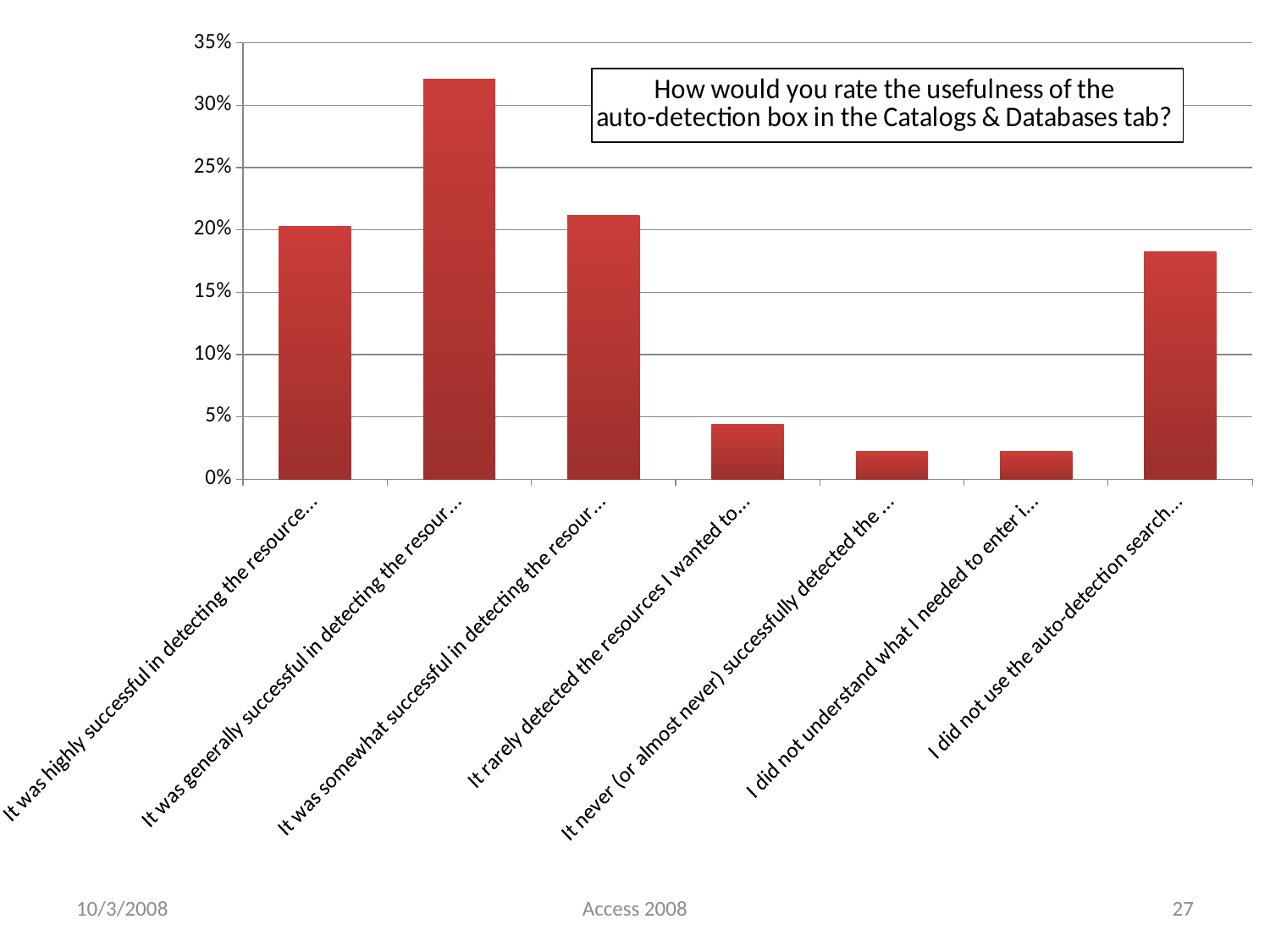
Which response category has the highest bar? It was generally successful in detecting the resour… Is the value for "It rarely detected the resources I wanted to…" greater or less than 10%? less Is the value for "It never (or almost never) successfully detected the …" greater or less than 5%? less Is the value for "I did not use the auto-detection search…" greater or less than 15%? greater Which is larger: the value for "It rarely detected the resources I wanted to…" or the value for "It was somewhat successful in detecting the resour…"? It was somewhat successful in detecting the resour… What kind of chart is shown on the slide? bar chart What colour are the bars in the chart? red What question does the chart's title box ask? How would you rate the usefulness of the auto-detection box in the Catalogs & Databases tab? Which is larger: the value for "It was generally successful in detecting the resour…" or the value for "I did not use the auto-detection search…"? It was generally successful in detecting the resour… How many bars (response categories) does the chart show? 7